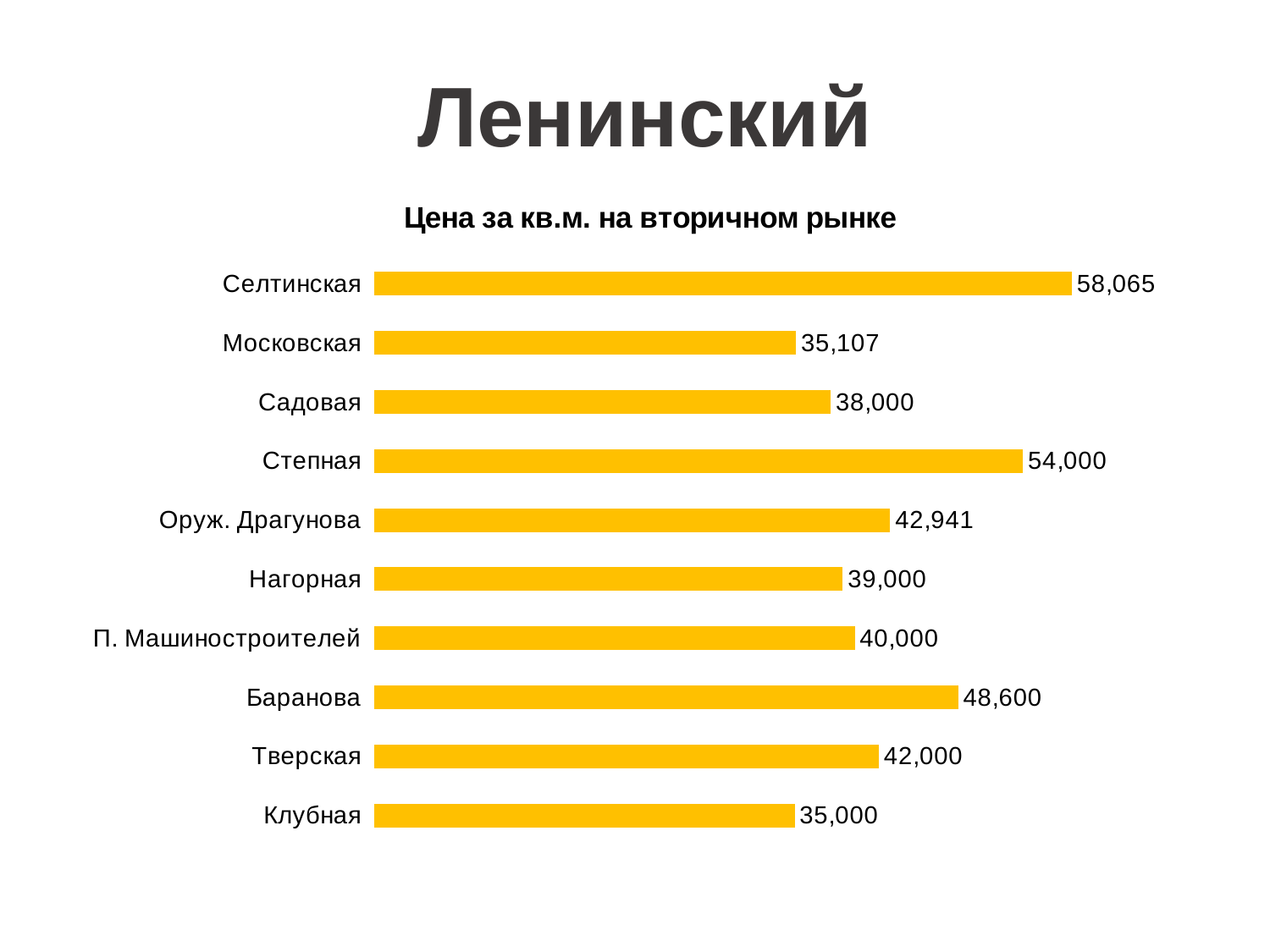
What is the value for Баранова? 48,600 What is the difference between the values for Селтинская and Степная? 4,065 What kind of chart is shown on the slide? Bar chart What is the value for Оруж. Драгунова? 42,941 Which is larger, the value for Московская or the value for Клубная? Московская Which category has the lowest value? Клубная Which category has the highest value? Селтинская What is the value for Селтинская? 58,065 How many categories are shown in the chart? 10 What is the title of the chart? Цена за кв.м. на вторичном рынке Which is larger, the value for Садовая or the value for Нагорная? Нагорная What is the difference between the values for Баранова and Тверская? 6,600